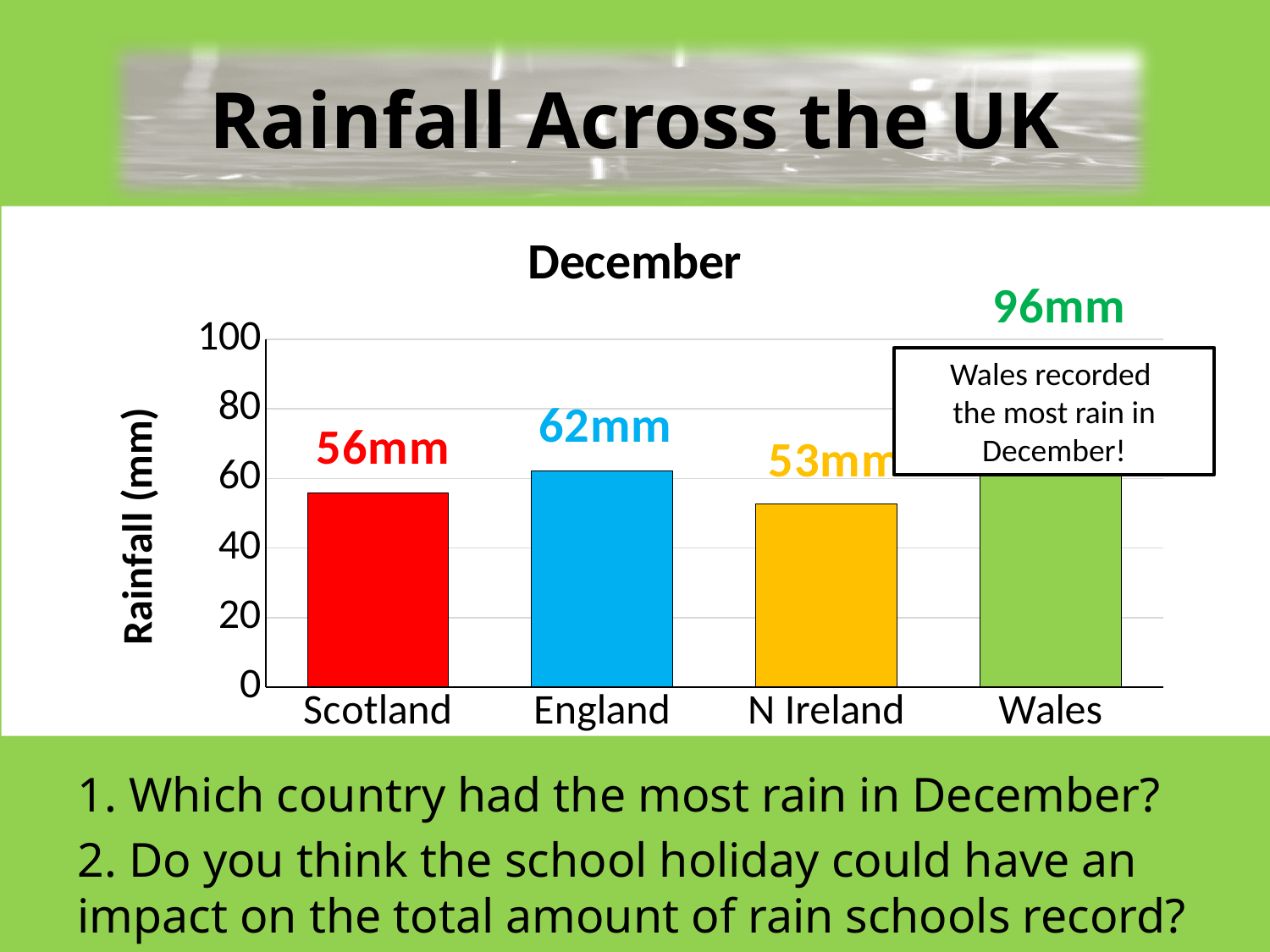
What is the rainfall value for N Ireland? 53mm What is the difference in rainfall between Wales and England? 34mm What is the difference in rainfall between Scotland and N Ireland? 3mm What is the rainfall value for England? 62mm What is the rainfall value for Wales? 96mm How many countries are shown in the chart? 4 Is the value for Wales greater or less than 80? greater What is the rainfall value for Scotland? 56mm Which country has the highest rainfall in the chart? Wales Which country has the lowest rainfall in the chart? N Ireland Which has more rainfall, England or Scotland? England What type of chart is shown on the slide? Bar chart